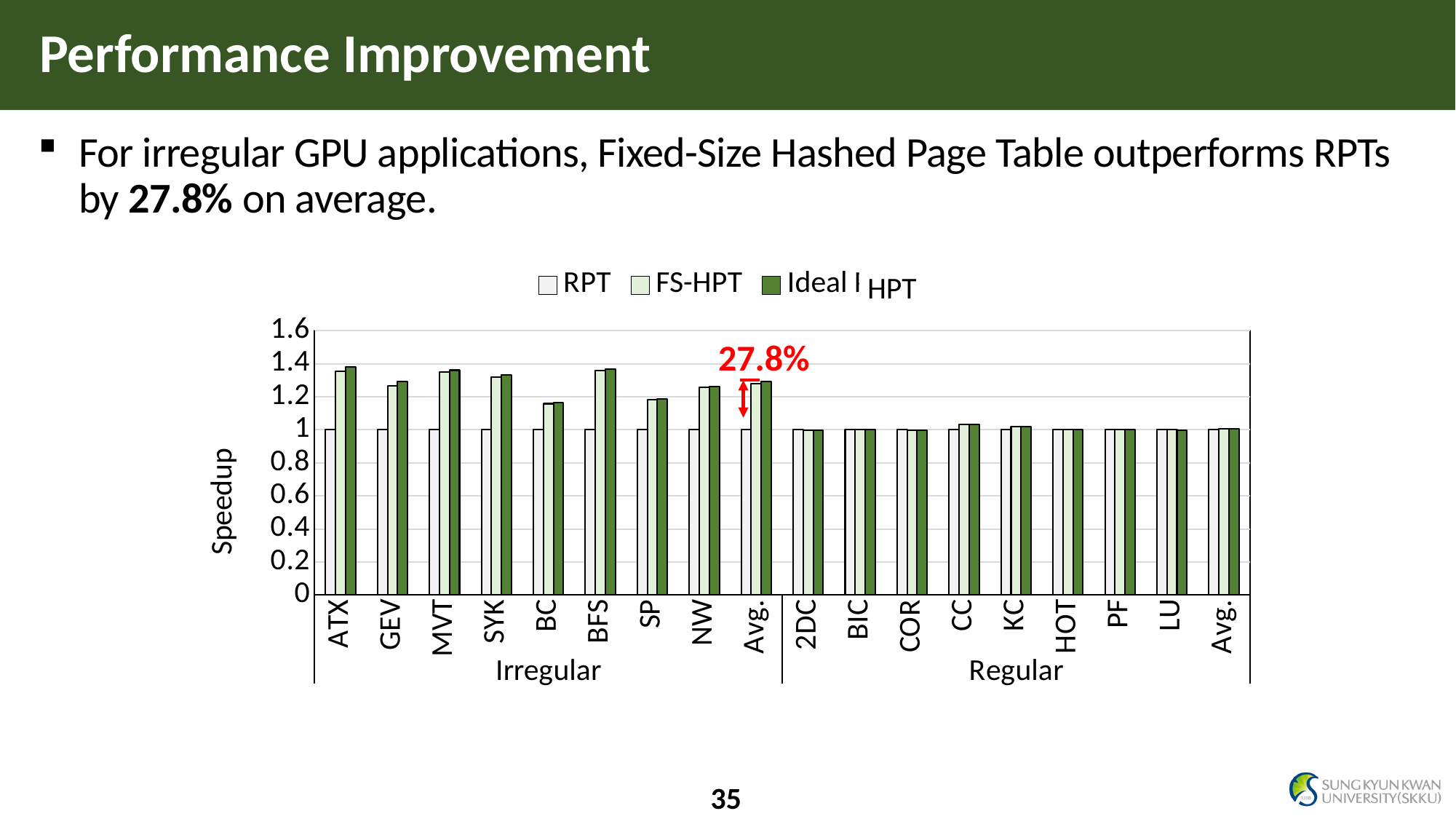
What is the RPT speedup value for BFS? 1 Is the Ideal HPT value for BFS greater or less than 1.2? greater What percentage improvement is annotated in red above the Irregular Avg. bars? 27.8% Which is larger, the FS-HPT value for ATX or the FS-HPT value for BC? ATX Is the FS-HPT value for ATX greater or less than 1.2? greater What is the RPT speedup value for ATX? 1 What is the label of the y axis of the chart? Speedup How many series does the chart legend list? 3 How many application categories are plotted along the x axis of the chart? 18 Is the FS-HPT value for BC greater or less than 1.2? less What kind of chart is shown on the slide? bar chart Which is larger, the Ideal HPT value for MVT or the Ideal HPT value for SP? MVT